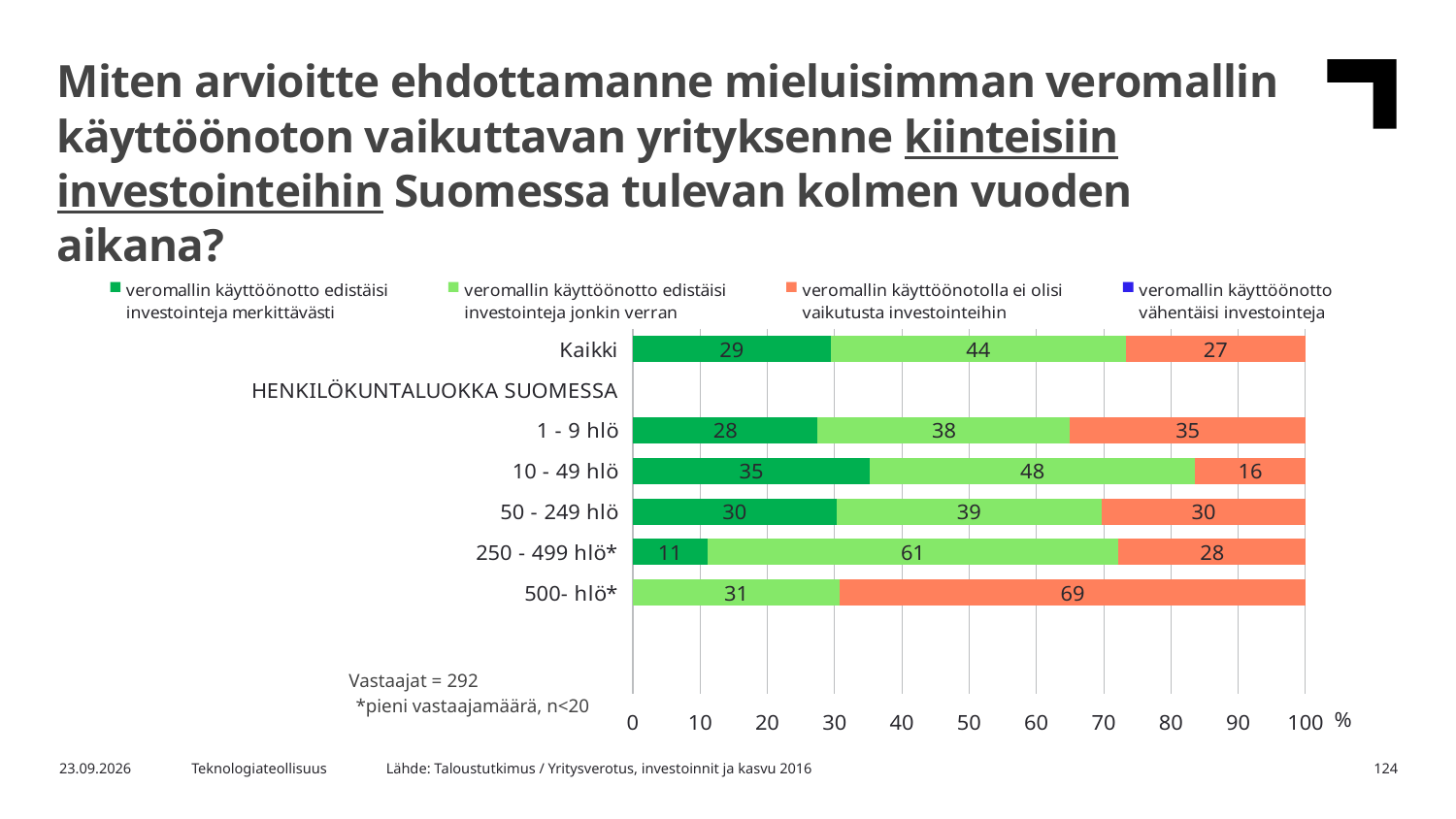
Which is larger: the 'edistäisi investointeja jonkin verran' value for 1 - 9 hlö or for 50 - 249 hlö? 50 - 249 hlö What is the value for 'veromallin käyttöönotolla ei olisi vaikutusta investointeihin' in the 500- hlö* bar? 69 What colour represents 'veromallin käyttöönotolla ei olisi vaikutusta investointeihin' in the chart? orange What is the value for 'veromallin käyttöönotto edistäisi investointeja jonkin verran' in the 250 - 499 hlö* bar? 61 How many series does the legend list? 4 What kind of chart is shown on the slide? stacked bar chart What is the total of the Kaikki stacked bar? 100 What is the value for 'veromallin käyttöönotto edistäisi investointeja merkittävästi' in the Kaikki bar? 29 Which category has the lowest value for 'veromallin käyttöönotolla ei olisi vaikutusta investointeihin'? 10 - 49 hlö What is the difference between the 'ei olisi vaikutusta' values for 500- hlö* and 10 - 49 hlö? 53 How many staff-size categories (excluding Kaikki) are plotted in the chart? 5 Which staff-size category has the highest value for 'veromallin käyttöönotto edistäisi investointeja merkittävästi'? 10 - 49 hlö